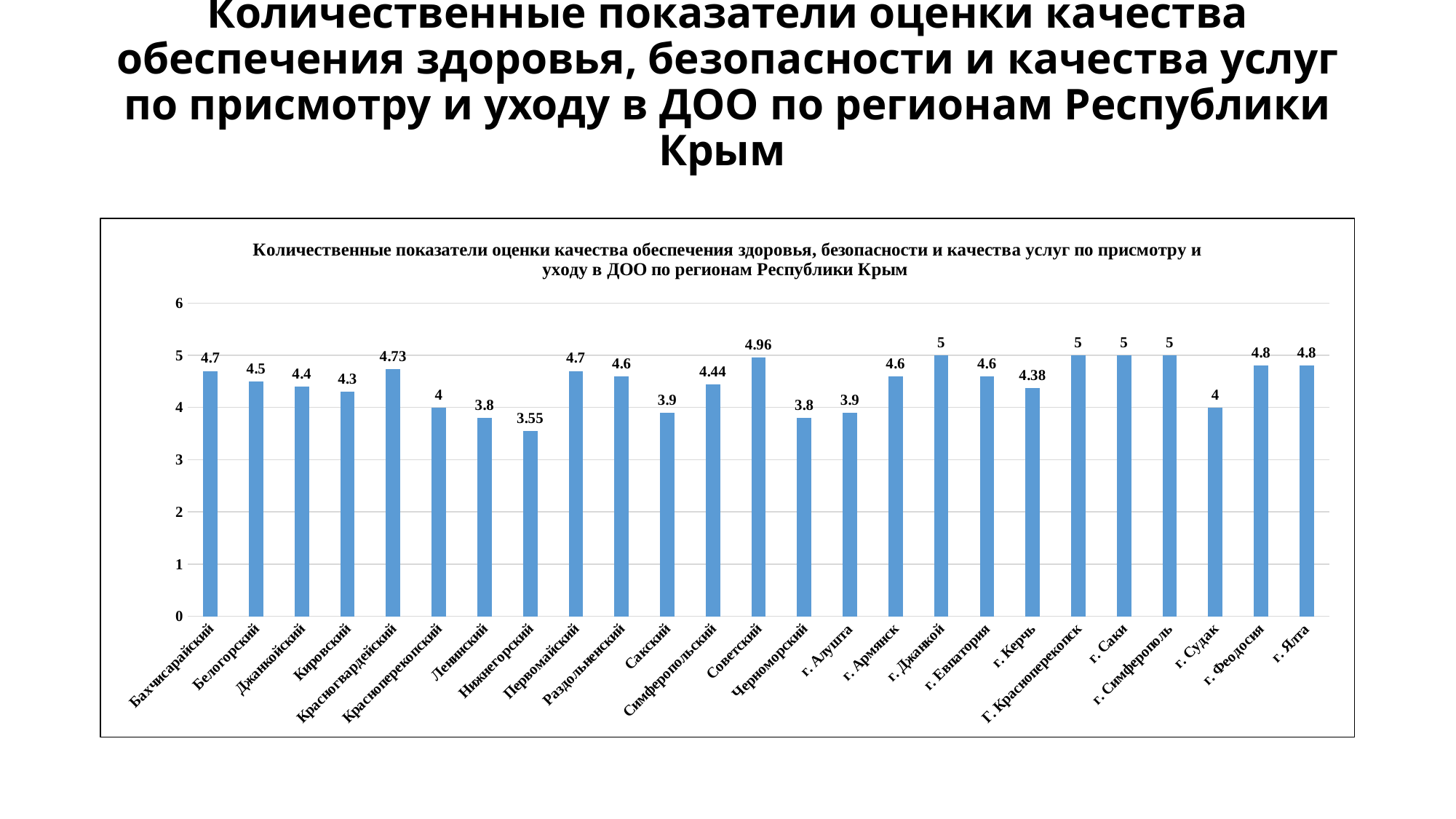
What is the value for Симферопольский? 4.44 What type of chart is shown on the slide? bar chart Which has a larger value, Кировский or Первомайский? Первомайский What is the value for Красногвардейский? 4.73 Is the value for Ленинский greater or less than 4? less What is the value for Советский? 4.96 Which region has the lowest value? Нижнегорский What is the highest value shown on the chart? 5 What is the difference between the values for г. Феодосия and г. Судак? 0.8 What is the difference between the values for Советский and Нижнегорский? 1.41 What is the value for г. Керчь? 4.38 How many regions are shown on the chart? 25